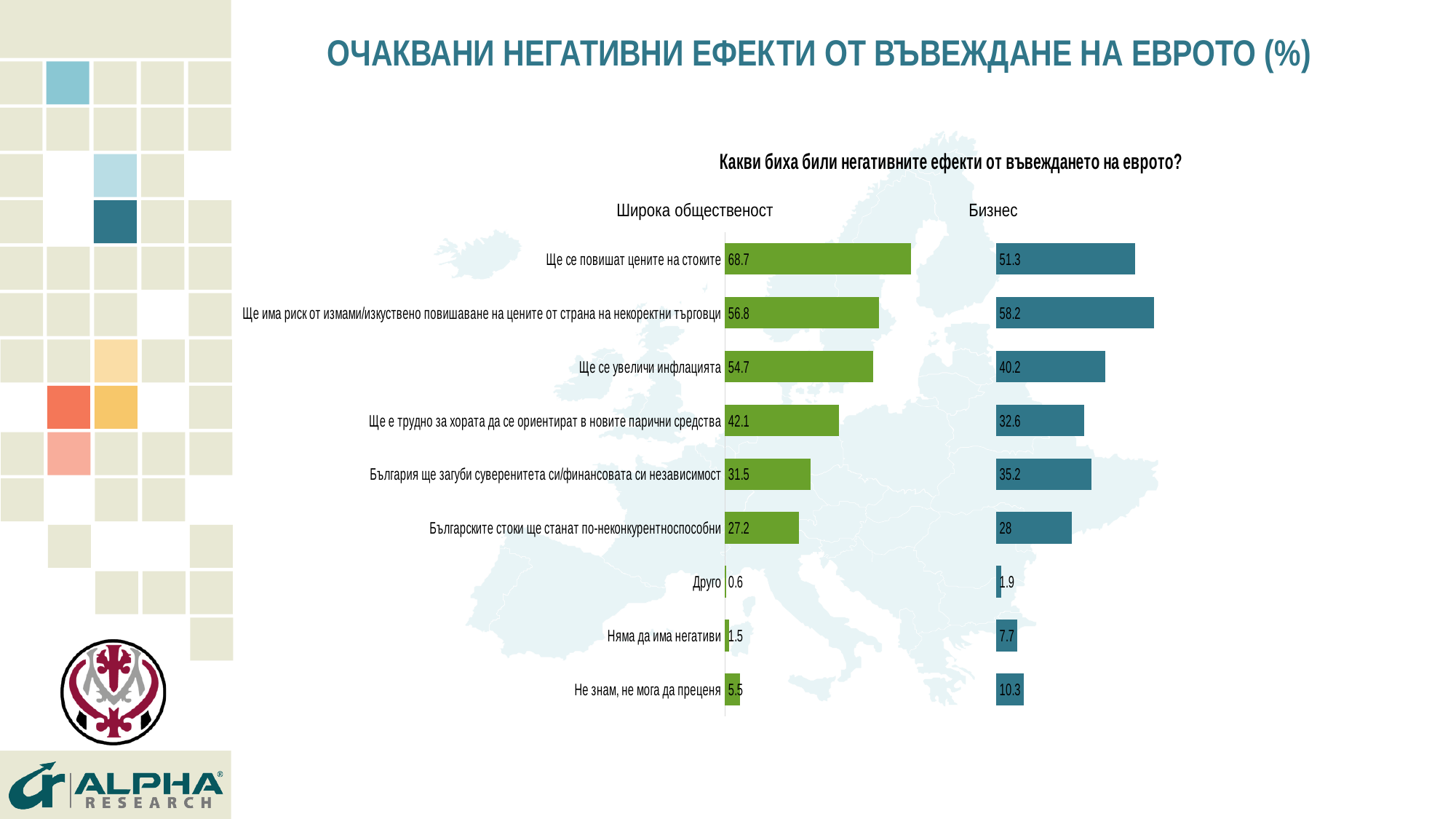
What kind of chart is used on this slide? Bar chart In the 'Бизнес' chart, which category has the highest value? Ще има риск от измами/изкуствено повишаване на цените от страна на некоректни търговци How many categories are shown in the 'Широка общественост' chart? 9 What is the title of the slide? ОЧАКВАНИ НЕГАТИВНИ ЕФЕКТИ ОТ ВЪВЕЖДАНЕ НА ЕВРОТО (%) In the 'Бизнес' chart, which category has the lowest value? Друго In the 'Бизнес' chart, what is the value for 'Не знам, не мога да преценя'? 10.3 In the 'Широка общественост' chart, what is the value for 'Ще се повишат цените на стоките'? 68.7 For 'България ще загуби суверенитета си/финансовата си независимост', which is larger: the 'Широка общественост' value or the 'Бизнес' value? Бизнес In the 'Бизнес' chart, what is the value for 'Ще се увеличи инфлацията'? 40.2 In the 'Широка общественост' chart, what is the difference between 'Ще се увеличи инфлацията' and 'Ще е трудно за хората да се ориентират в новите парични средства'? 12.6 What is the difference between the 'Широка общественост' and 'Бизнес' values for 'Ще се повишат цените на стоките'? 17.4 In the 'Широка общественост' chart, which category has the lowest value? Друго